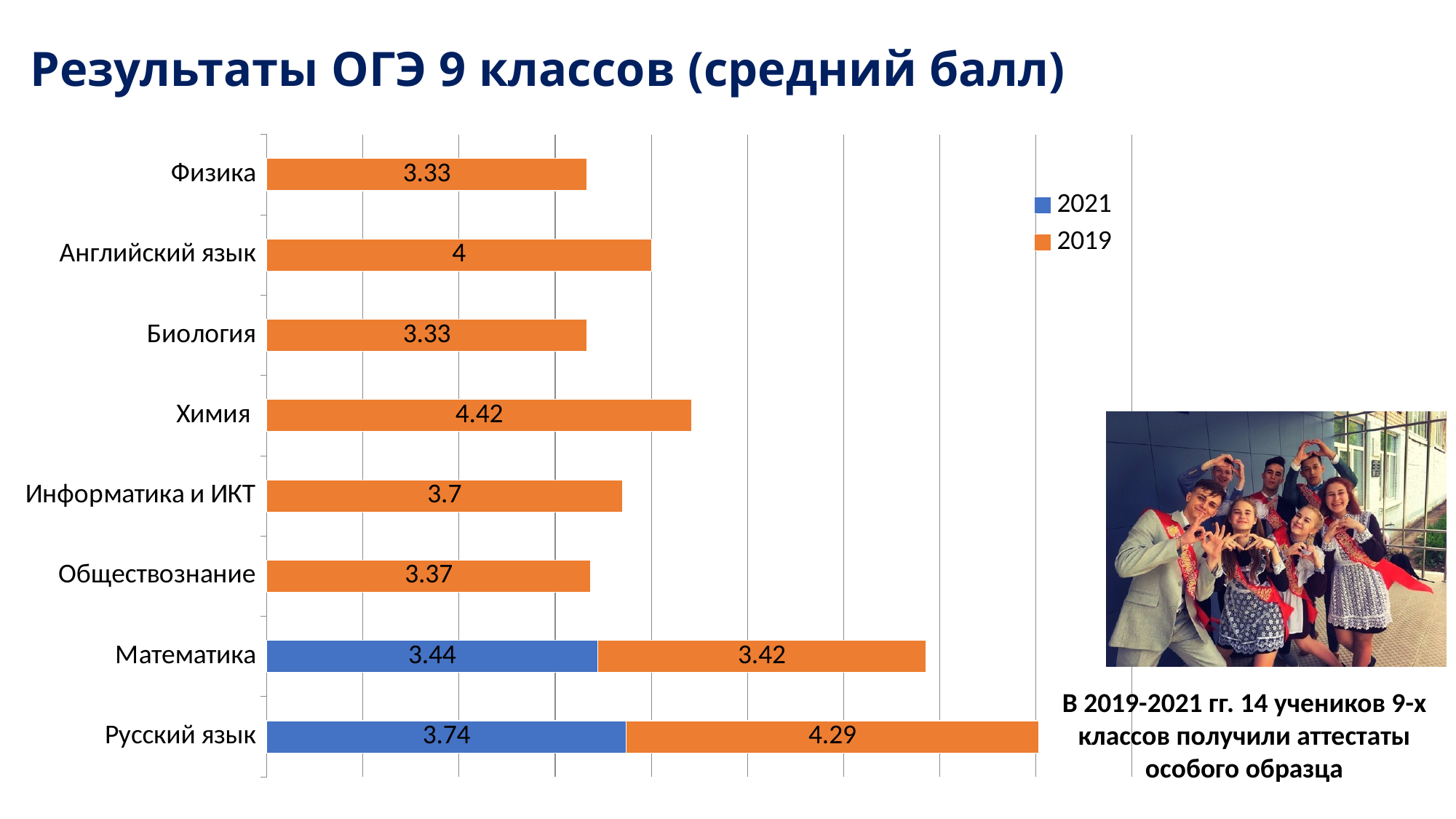
How many series does the legend list? 2 What is the total of the stacked bar for Русский язык? 8.03 What is the 2019 value for Английский язык? 4 What kind of chart is shown on the slide? Bar chart What is the title of the chart? Результаты ОГЭ 9 классов (средний балл) What is the 2021 value for Математика? 3.44 How many categories are shown on the chart? 8 Which is larger for Русский язык: the 2019 value or the 2021 value? 2019 What is the 2021 value for Русский язык? 3.74 What is the difference between the 2019 values for Химия and Физика? 1.09 What is the 2019 value for Химия? 4.42 Which category has the highest 2019 value? Химия